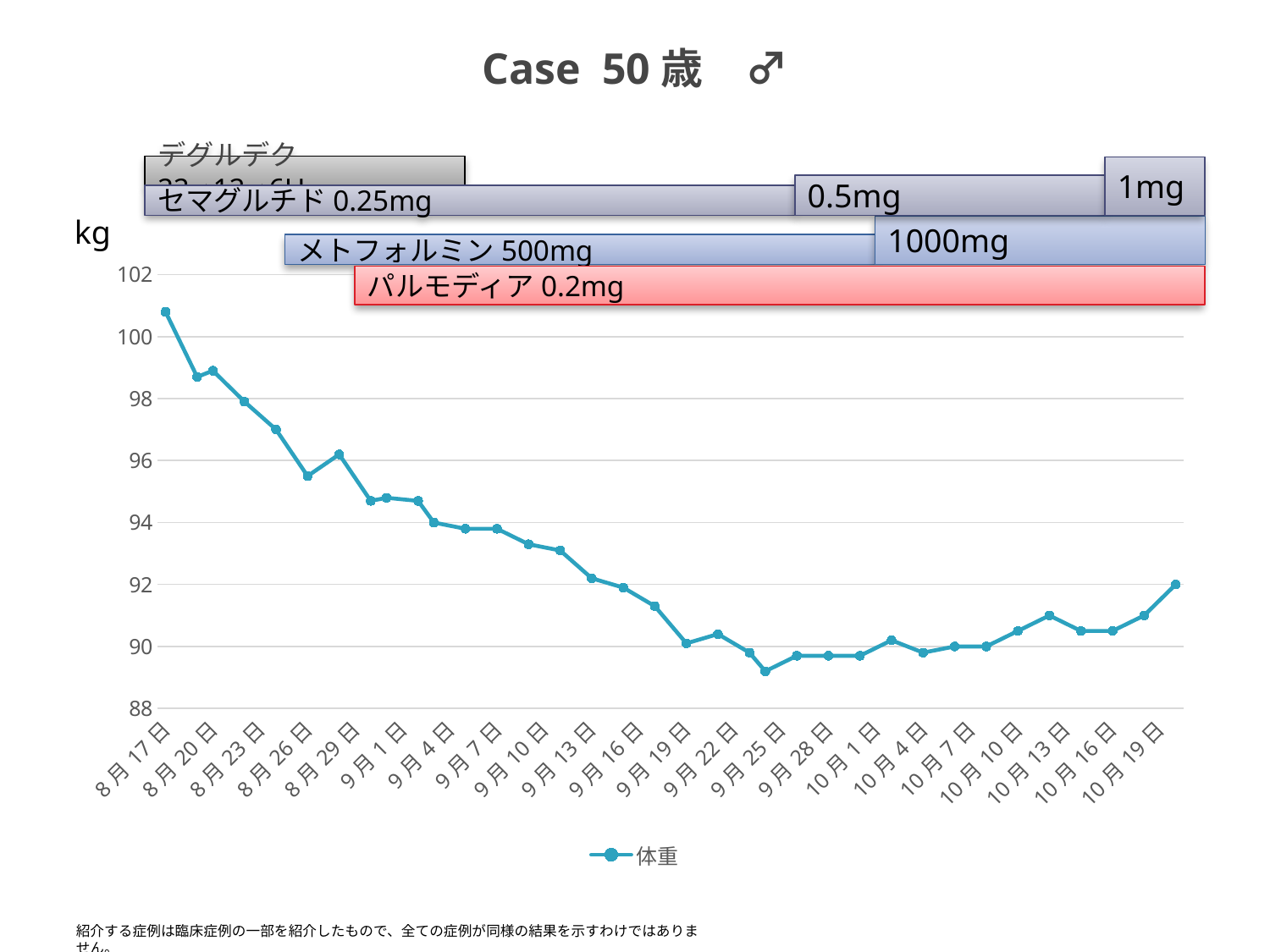
Is the body weight on 8月26日 greater or less than 96? less What is the name of the series shown in the legend? 体重 Does the body weight mainly rise or fall from 8月17日 to 9月25日? fall On which date is the body weight highest? 8月17日 Is the body weight on 9月10日 greater or less than 94? less Which is larger, the body weight on 8月17日 or on 10月19日? 8月17日 How many series does the legend list? 1 Is the body weight on 8月17日 greater or less than 100? greater What unit is shown for the vertical axis? kg What kind of chart is shown on the slide? line chart